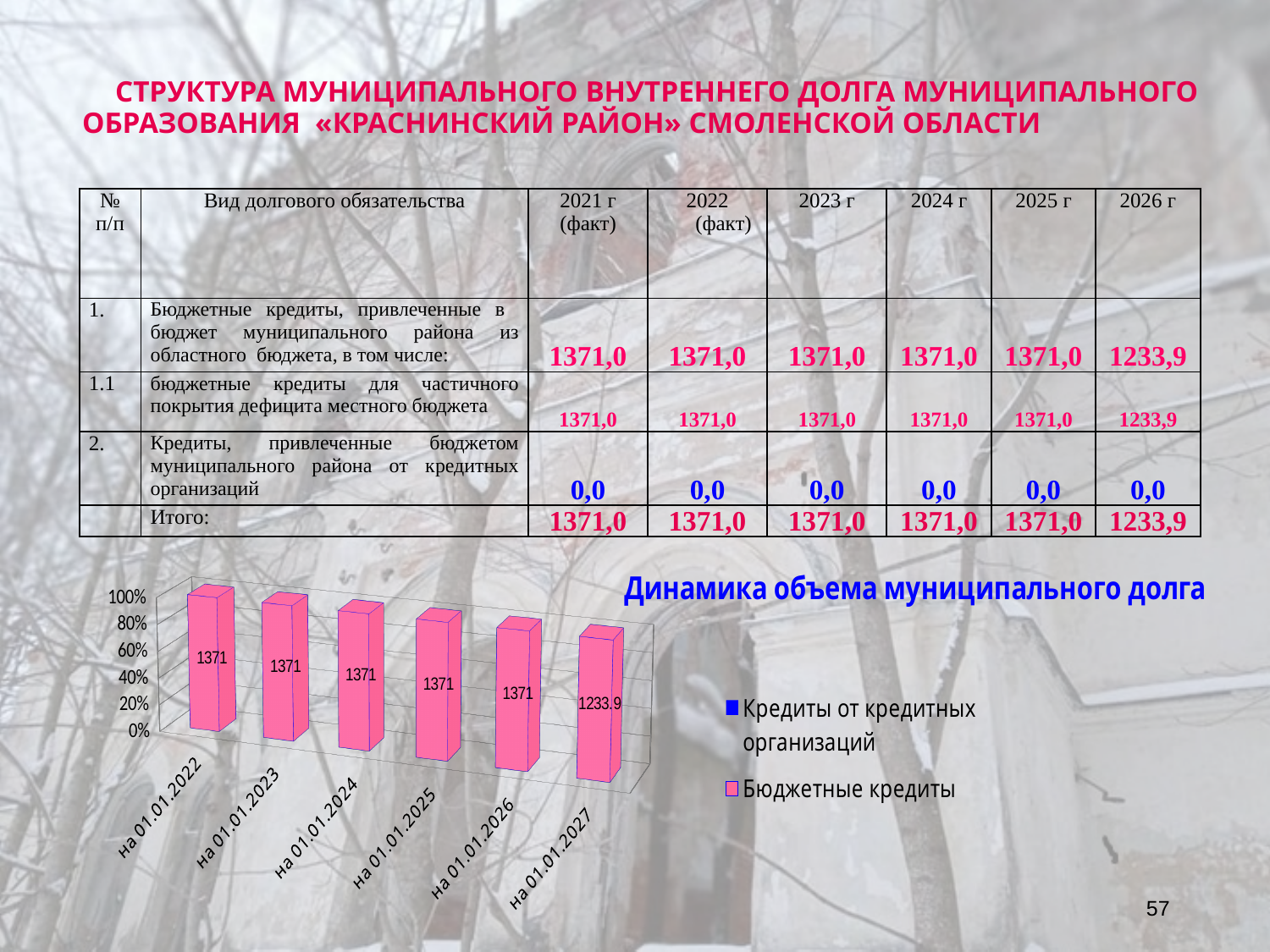
What is the value labelled on the bar for на 01.01.2022? 1371 What is the title of the chart on the slide? Динамика объема муниципального долга How many categories are shown on the x axis of the chart? 6 Which category has the lowest labelled value in the chart? на 01.01.2027 How many categories in the chart have a labelled value of 1371? 5 Which legend entry is shown in pink in the chart? Бюджетные кредиты What is the value labelled on the bar for на 01.01.2027? 1233.9 What kind of chart is shown under the table? bar chart Do the labelled values rise or fall from на 01.01.2026 to на 01.01.2027? fall What is the difference between the labelled values for на 01.01.2026 and на 01.01.2027? 137.1 Which is larger, the labelled value for на 01.01.2023 or for на 01.01.2027? на 01.01.2023 How many series does the chart legend list? 2